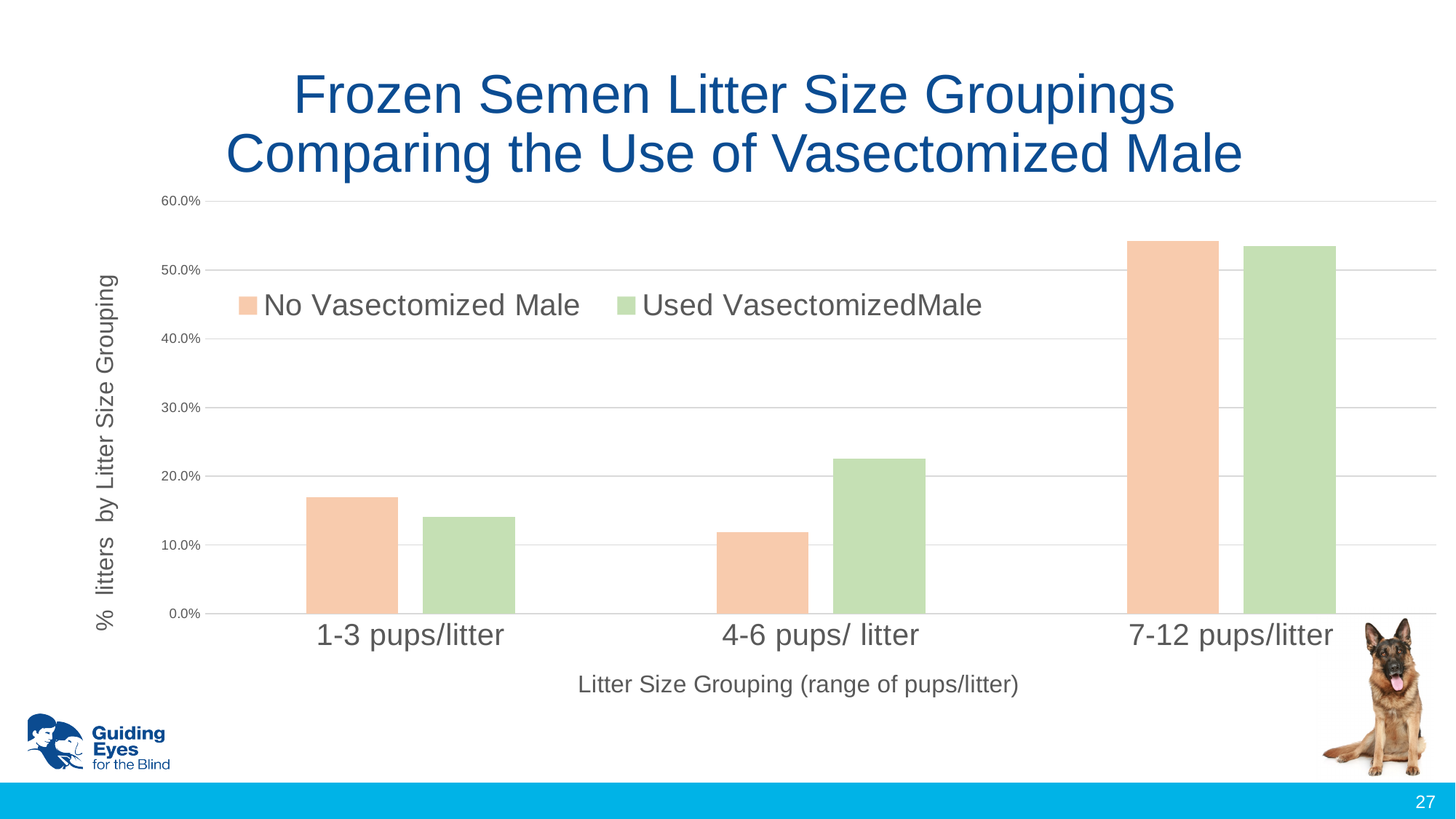
What kind of chart is shown on the slide? bar chart How many litter size groupings are shown on the x axis? 3 Which litter size grouping has the lowest value for Used VasectomizedMale? 1-3 pups/litter How many series does the legend list? 2 For 4-6 pups/ litter, which series has the larger value, No Vasectomized Male or Used VasectomizedMale? Used VasectomizedMale Which litter size grouping has the lowest value for No Vasectomized Male? 4-6 pups/ litter Is the value for No Vasectomized Male at 4-6 pups/ litter greater or less than 20.0%? less What is the label of the x axis? Litter Size Grouping (range of pups/litter) Is the value for No Vasectomized Male at 7-12 pups/litter greater or less than 50.0%? greater Is the value for Used VasectomizedMale at 4-6 pups/ litter greater or less than 20.0%? greater Which litter size grouping has the highest value for No Vasectomized Male? 7-12 pups/litter For 1-3 pups/litter, which series has the larger value, No Vasectomized Male or Used VasectomizedMale? No Vasectomized Male